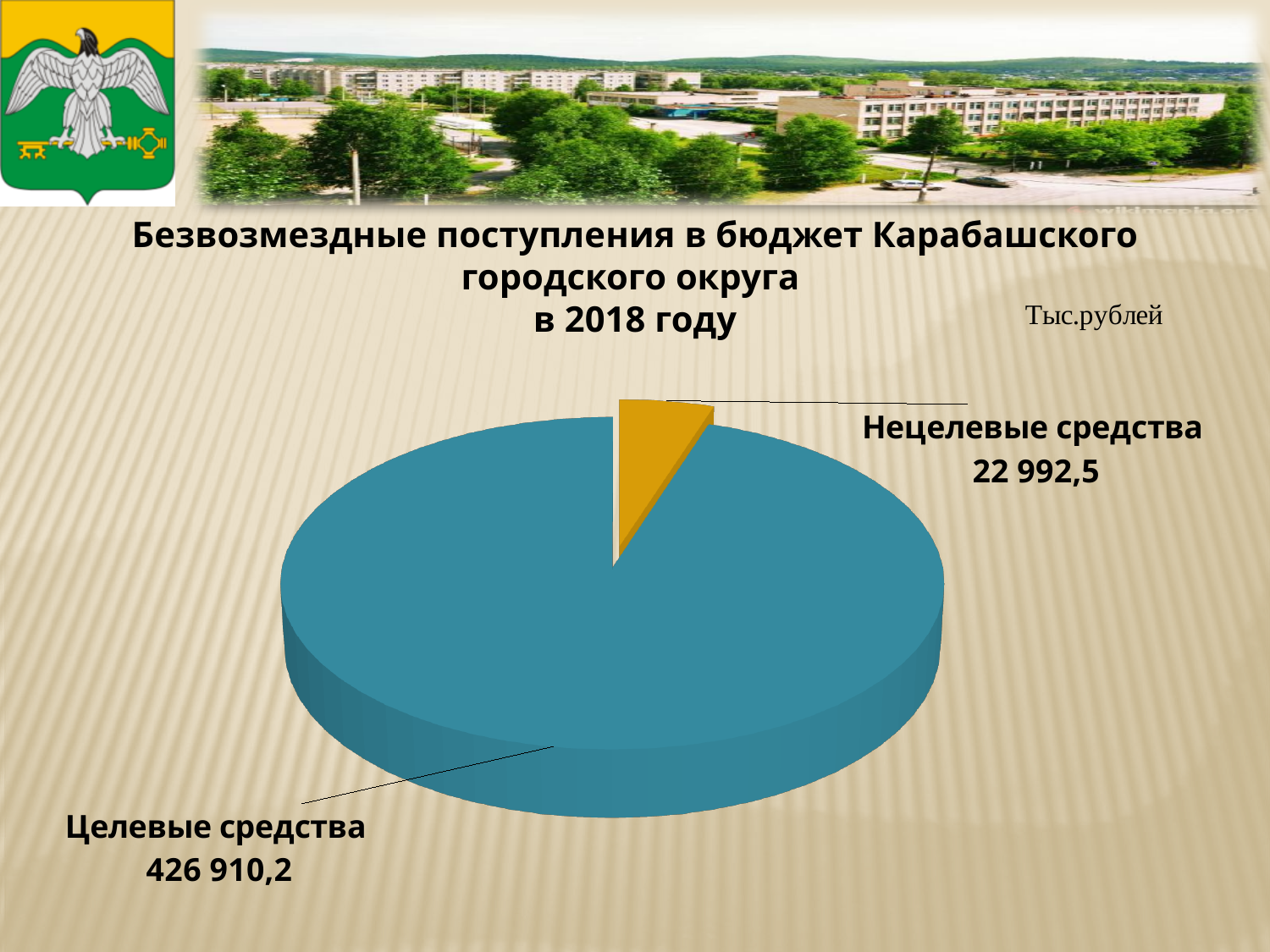
What unit of measurement is indicated for the chart values? Тыс.рублей What type of chart is shown on the slide? pie chart What is the value for Целевые средства? 426 910,2 Which category has the smallest slice of the pie? Нецелевые средства What is the total of the two slices in the pie chart? 449 902,7 What year does the chart title refer to? 2018 What is the value for Нецелевые средства? 22 992,5 What is the difference between Целевые средства and Нецелевые средства? 403 917,7 Which category has the largest slice of the pie? Целевые средства Which is larger, Целевые средства or Нецелевые средства? Целевые средства What colour is the slice for Нецелевые средства? orange (gold) How many slices does the pie chart have? 2